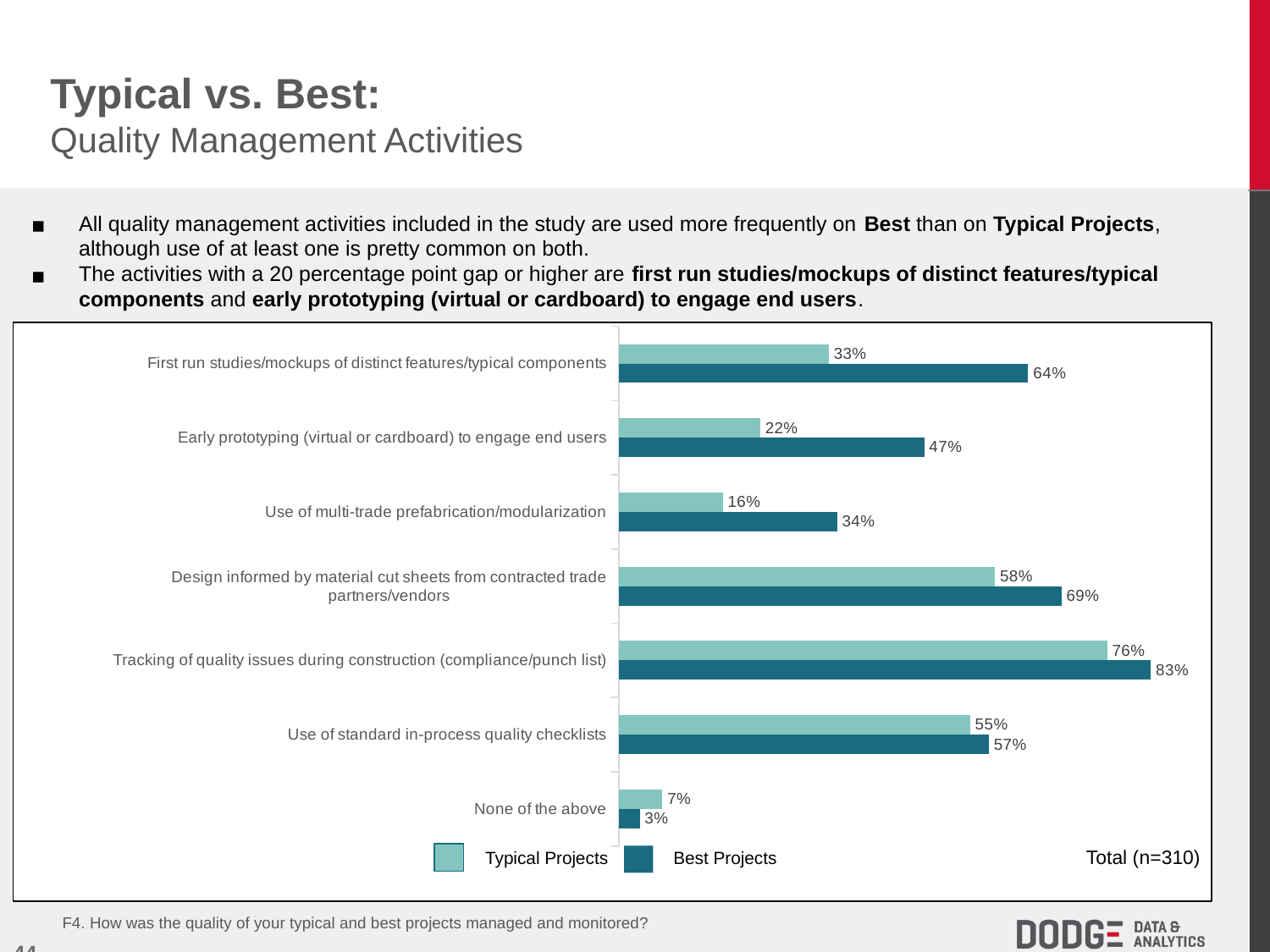
What is the difference between Best Projects and Typical Projects for Design informed by material cut sheets from contracted trade partners/vendors? 11% What is the difference between Best Projects and Typical Projects for Early prototyping (virtual or cardboard) to engage end users? 25% Which category has the highest value for Best Projects? Tracking of quality issues during construction (compliance/punch list) Which category has the lowest value for Typical Projects? None of the above How many series does the legend list? 2 What kind of chart is shown on the slide? Bar chart What is the value for Typical Projects for Early prototyping (virtual or cardboard) to engage end users? 22% What is the value for Best Projects for First run studies/mockups of distinct features/typical components? 64% Which is larger for None of the above: Typical Projects or Best Projects? Typical Projects What sample size is noted on the chart? Total (n=310) What is the value for Best Projects for Use of multi-trade prefabrication/modularization? 34% How many categories are shown on the chart? 7